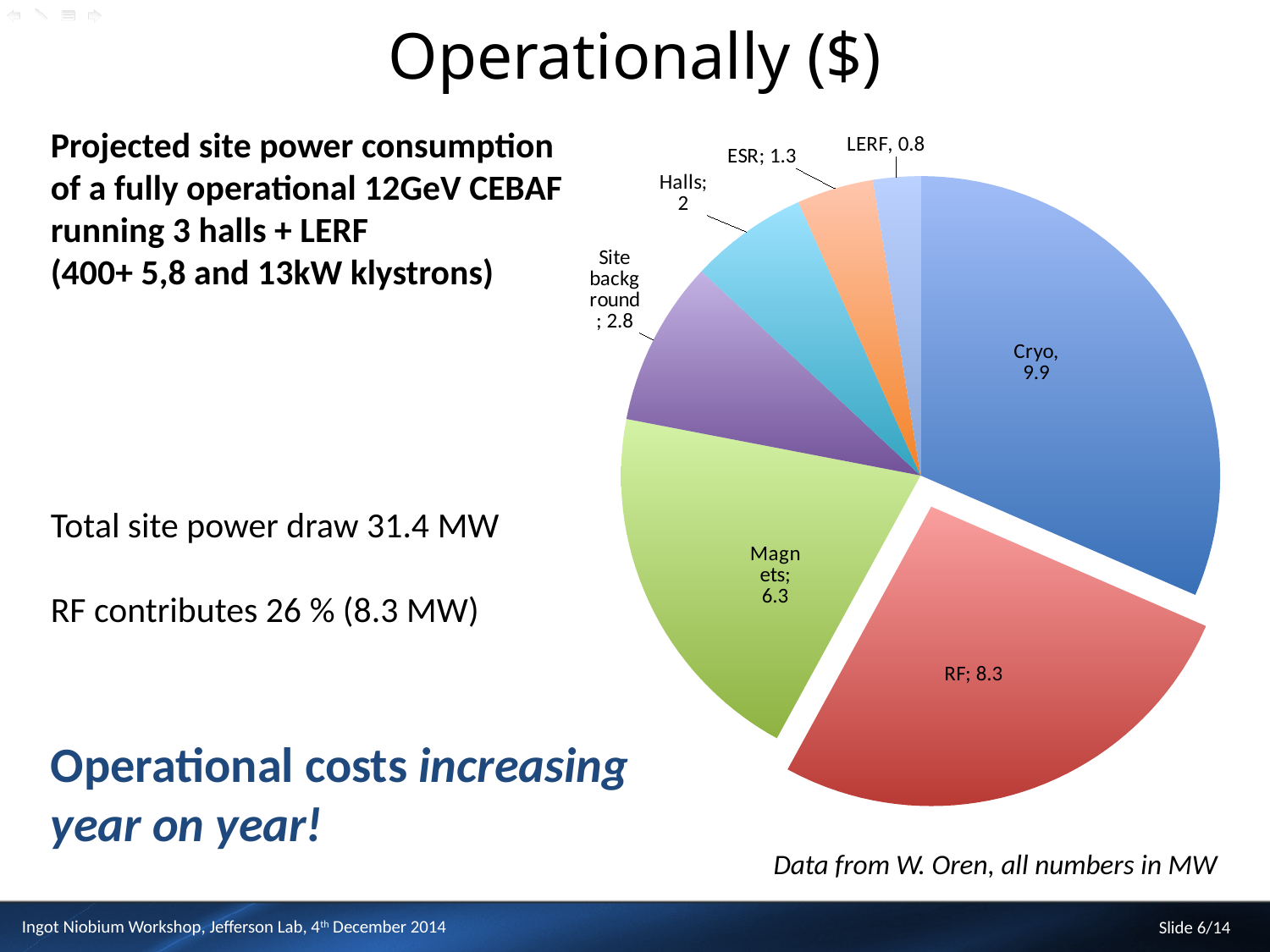
What is the value for Magnets in the pie chart? 6.3 What share of the total site power does RF contribute, according to the slide? 26 % What is the value for Cryo in the pie chart? 9.9 Which category has the smallest slice in the pie chart? LERF What is the difference between the Cryo and RF values in the pie chart? 1.6 How many slices does the pie chart have? 7 What is the value for RF in the pie chart? 8.3 What is the value for ESR in the pie chart? 1.3 What kind of chart is shown on the slide? pie chart What is the value for Site background in the pie chart? 2.8 Which is larger in the pie chart, Magnets or Site background? Magnets Which category has the largest slice in the pie chart? Cryo